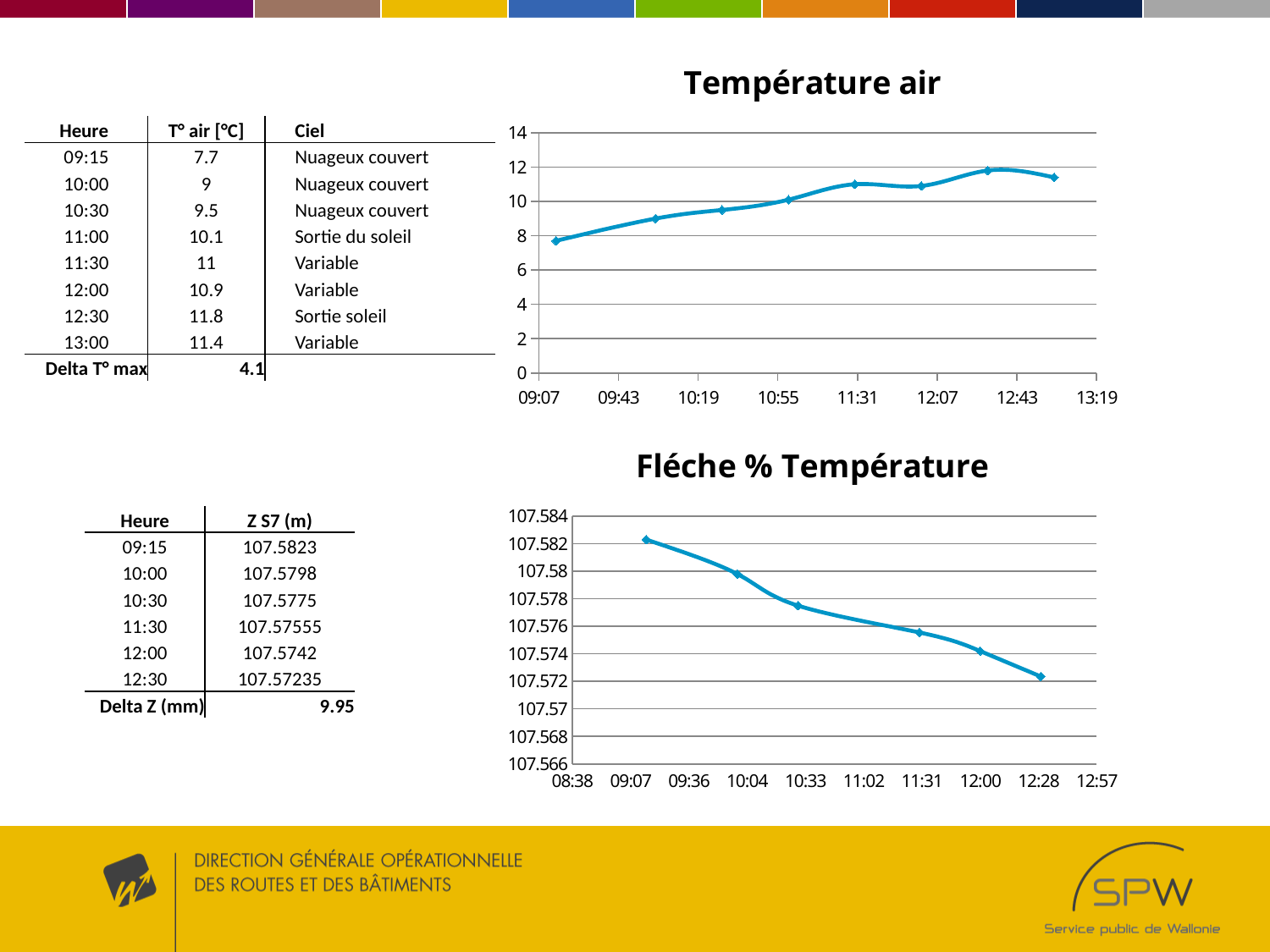
On the "Température air" chart, is the first plotted value (at 09:15) greater or less than 8? less According to the table beside the "Température air" chart, at which time is the air temperature lowest? 09:15 On the "Fléche % Température" chart, do the values rise or fall from left to right along the x axis? fall How many data points are plotted on the "Fléche % Température" chart? 6 According to the table beside the "Température air" chart, what is the air temperature at 12:30? 11.8 How many data points are plotted on the "Température air" chart? 8 On the "Température air" chart, do the values generally rise or fall from left to right along the x axis? rise What kind of chart is the "Température air" chart? line chart On the "Fléche % Température" chart, is the last plotted value (at 12:30) greater or less than 107.574? less What kind of chart is the "Fléche % Température" chart? line chart According to the table beside the "Fléche % Température" chart, what is the Z S7 (m) value at 09:15? 107.5823